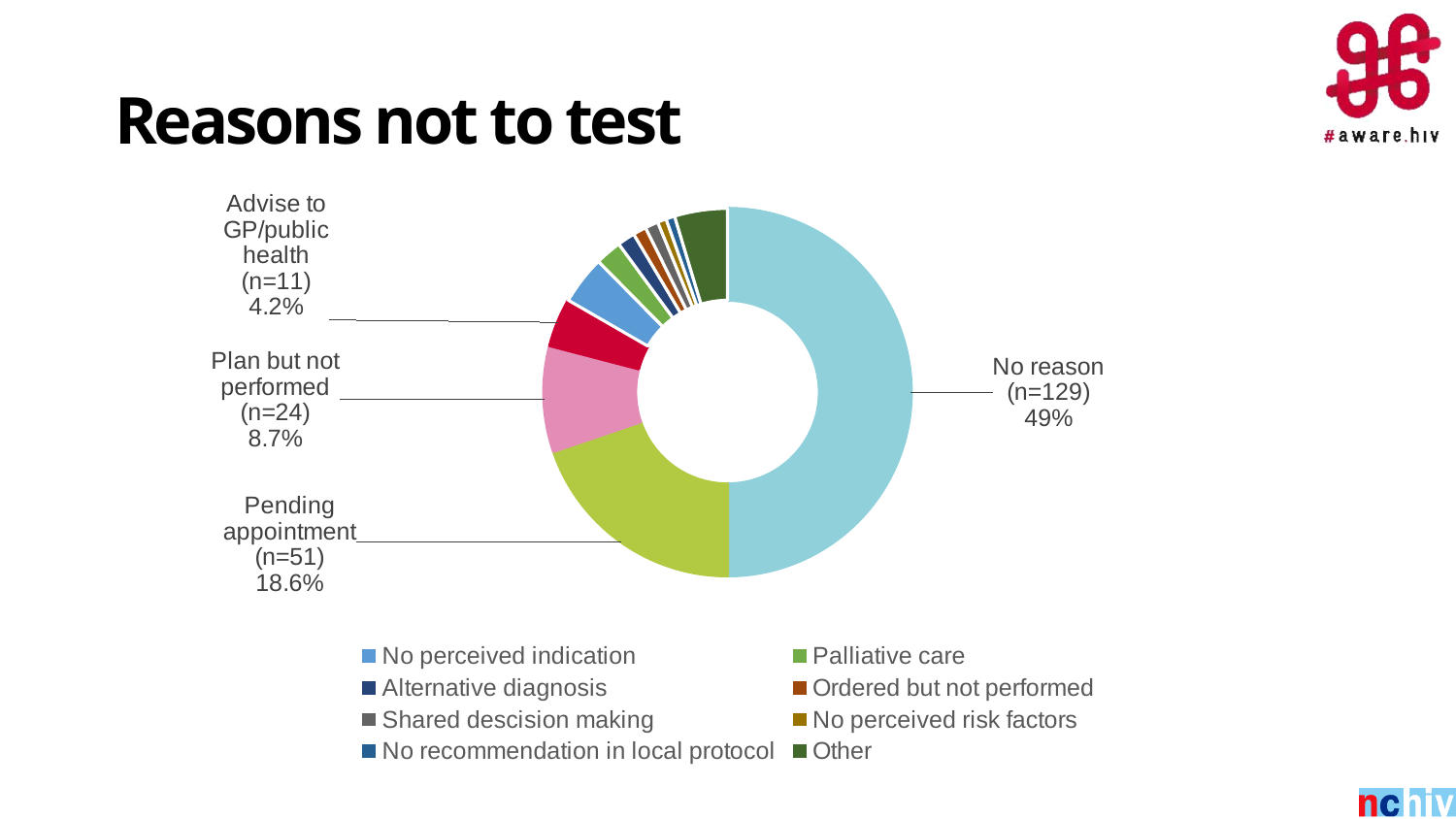
How many more cases are in 'No reason' (n=129) than in 'Pending appointment' (n=51)? 78 Which is larger, the slice for 'Pending appointment' or the slice for 'Plan but not performed'? Pending appointment What is the title of the chart? Reasons not to test What kind of chart is shown on the slide? doughnut chart Which reason has the largest slice of the chart? No reason How many entries does the legend below the chart list? 8 What is the difference in percentage points between 'Pending appointment' (18.6%) and 'Plan but not performed' (8.7%)? 9.9 What percentage of the chart does the 'No reason' slice represent? 49% What percentage is shown for 'Advise to GP/public health'? 4.2% What is the n value for 'Pending appointment'? 51 What is the n value for 'Advise to GP/public health'? 11 What percentage is shown for 'Plan but not performed'? 8.7%